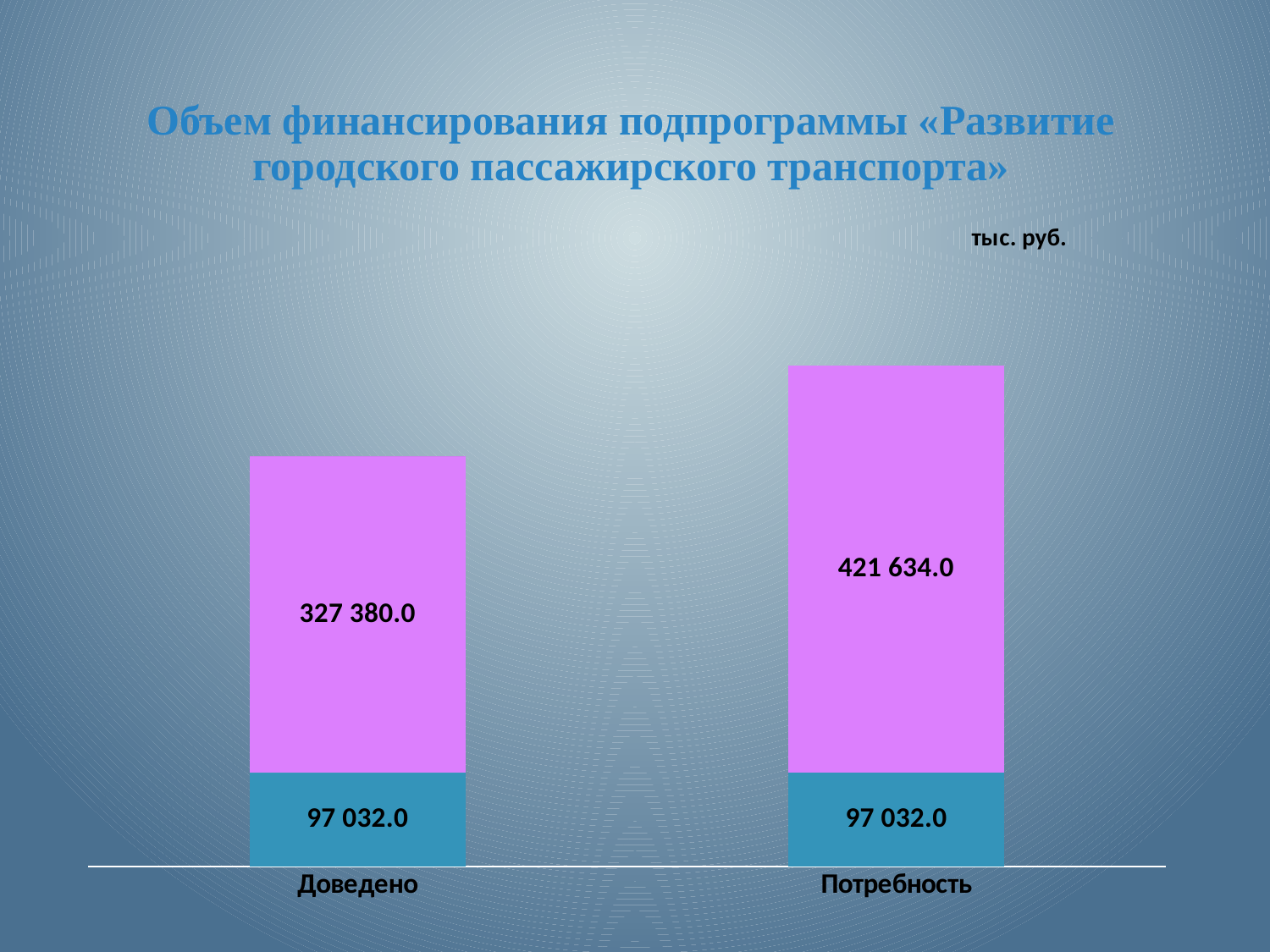
How many categories are shown on the x axis of the chart? 2 Which category has the tallest stacked bar overall? Потребность What kind of chart is shown on the slide? stacked bar chart What is the total of the stacked bar for Потребность? 518 666.0 What is the difference between the purple segment values for Потребность and Доведено? 94 254.0 What is the value of the purple (upper) segment for Потребность? 421 634.0 What unit of measurement is indicated on the slide for the chart values? тыс. руб. Which category has the larger purple (upper) segment, Доведено or Потребность? Потребность What is the value of the purple (upper) segment for Доведено? 327 380.0 What is the value of the blue (lower) segment for Потребность? 97 032.0 What is the value of the blue (lower) segment for Доведено? 97 032.0 What is the total of the stacked bar for Доведено? 424 412.0